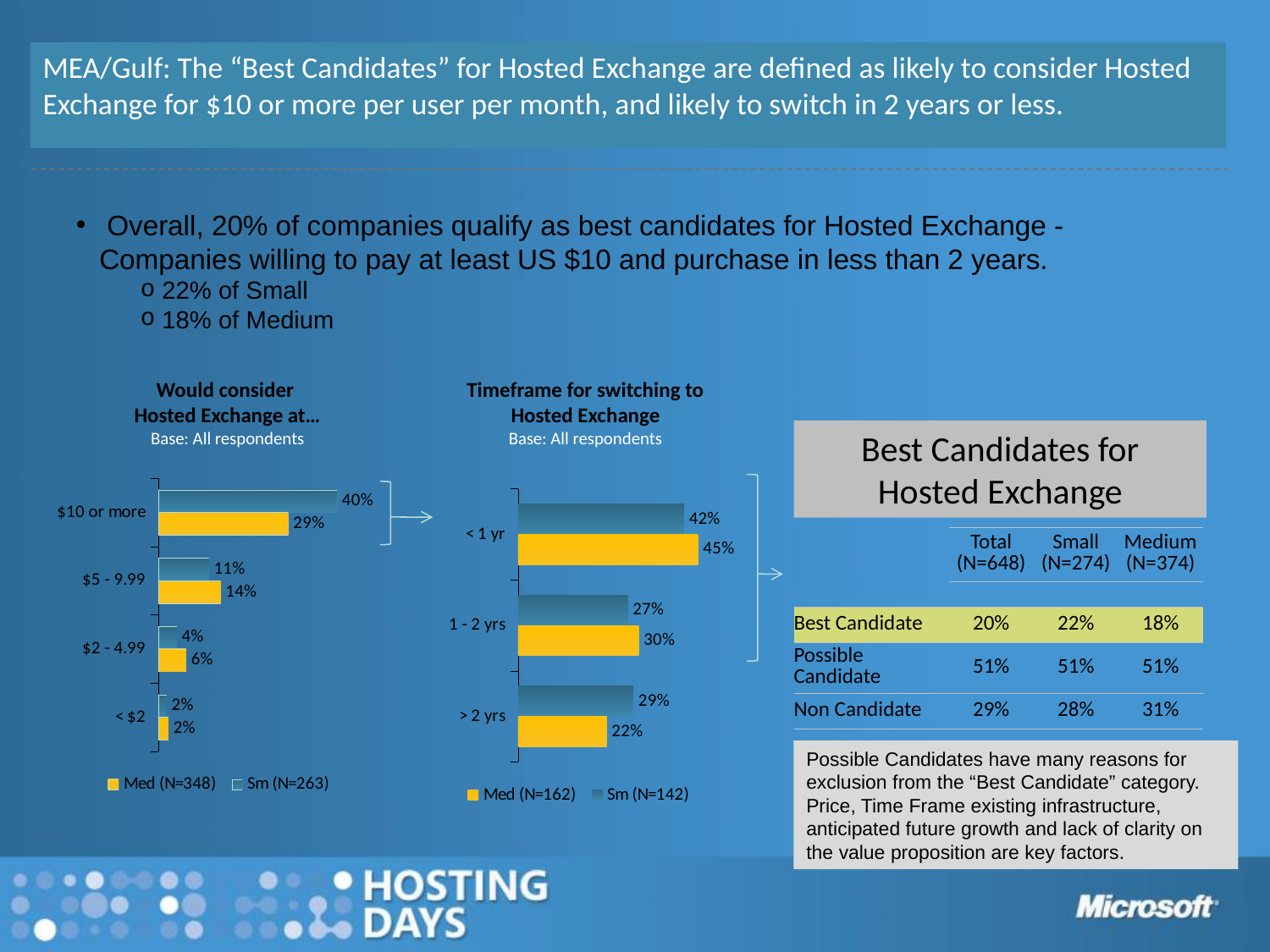
In the "Would consider Hosted Exchange at..." chart, how many series does the legend list? 2 In the "Timeframe for switching to Hosted Exchange" chart, which is larger for "> 2 yrs": the Med value or the Sm value? Sm In the "Would consider Hosted Exchange at..." chart, what is the Sm value for "$10 or more"? 40% What type of chart is the "Timeframe for switching to Hosted Exchange" chart? Bar chart In the "Timeframe for switching to Hosted Exchange" chart, what are the two legend entries? Med (N=162) and Sm (N=142) In the "Timeframe for switching to Hosted Exchange" chart, what is the Med value for "< 1 yr"? 45% In the "Timeframe for switching to Hosted Exchange" chart, what is the Sm value for "> 2 yrs"? 29% In the "Would consider Hosted Exchange at..." chart, what is the Med value for "$5 - 9.99"? 14% In the "Would consider Hosted Exchange at..." chart, how many price categories are shown? 4 In the "Would consider Hosted Exchange at..." chart, what is the difference between the Sm and Med values for "$10 or more"? 11% In the "Timeframe for switching to Hosted Exchange" chart, what is the difference between the Med and Sm values for "1 - 2 yrs"? 3% In the "Would consider Hosted Exchange at..." chart, which category has the highest Med value? $10 or more